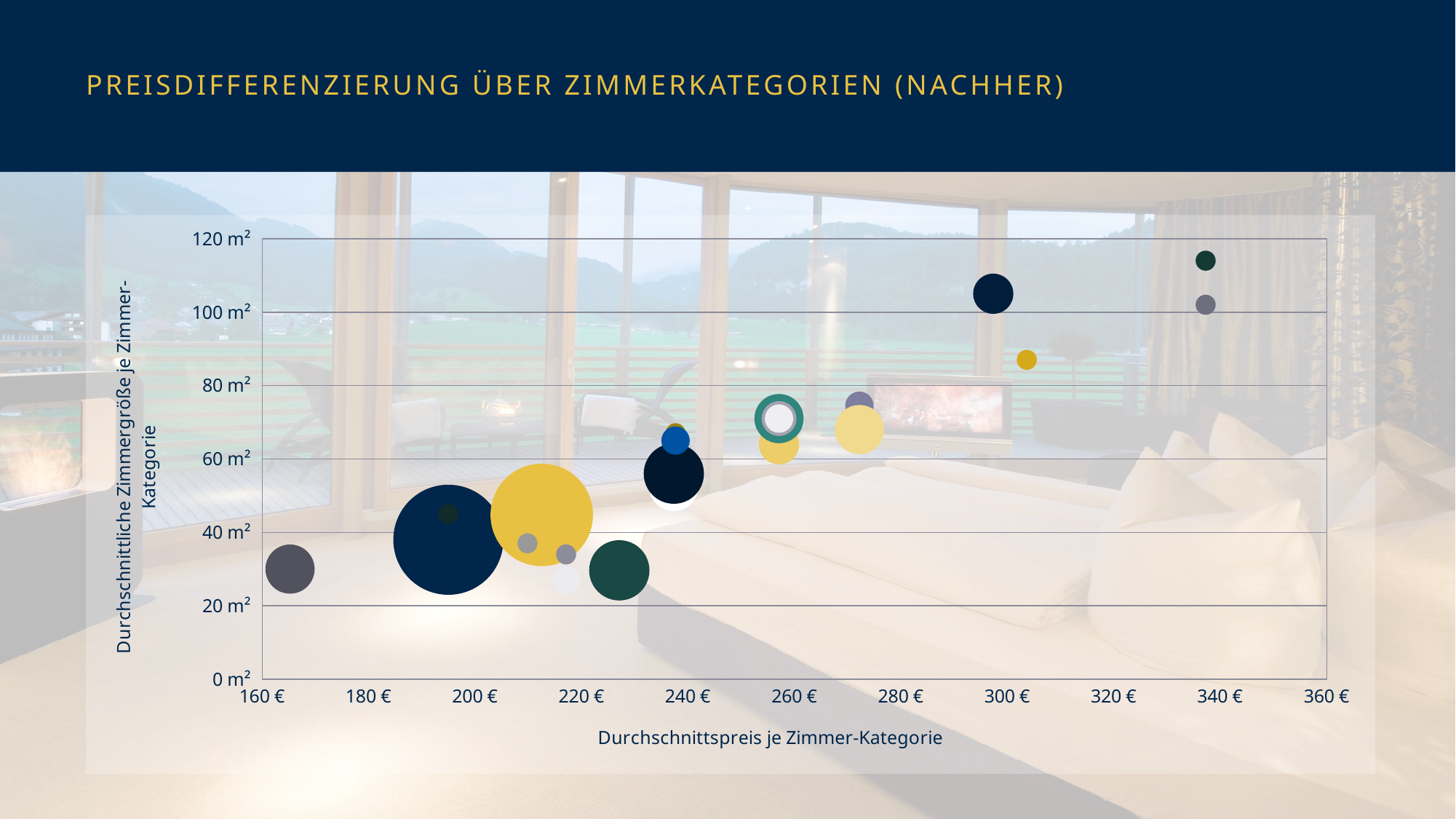
What is the title of the vertical axis of the chart? Durchschnittliche Zimmergröße je Zimmer-Kategorie Is the room size for the small dark green bubble located around 337 € greater or less than 100 m²? greater Is the room size for the grey bubble located around 165 € greater or less than 40 m²? less What kind of chart is shown on the slide? bubble chart What is the title of the horizontal axis of the chart? Durchschnittspreis je Zimmer-Kategorie Is the room size for the large gold bubble located around 212 € greater or less than 40 m²? greater As the average price increases along the x axis, do the average room sizes generally rise or fall? rise